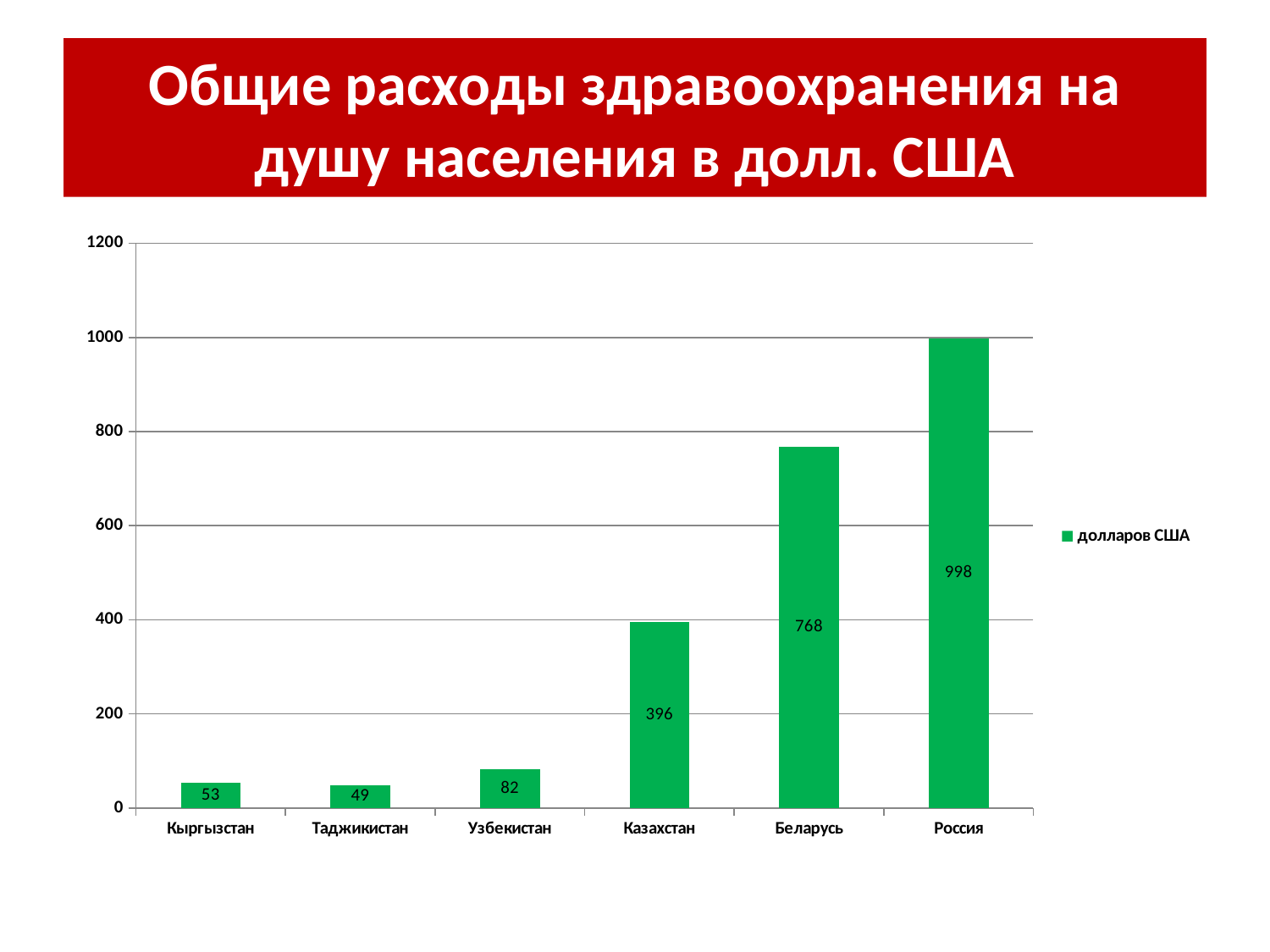
What is the difference between the values for Россия and Беларусь? 230 What is the value for Казахстан? 396 Which country has the lowest value? Таджикистан Which is larger, the value for Узбекистан or the value for Кыргызстан? Узбекистан What is the value for Таджикистан? 49 What is the value for Беларусь? 768 Which country has the highest value? Россия Is the value for Беларусь greater or less than 600? greater How many countries are shown on the chart? 6 What is the legend entry for the series? долларов США How many series does the legend list? 1 What kind of chart is shown on the slide? bar chart